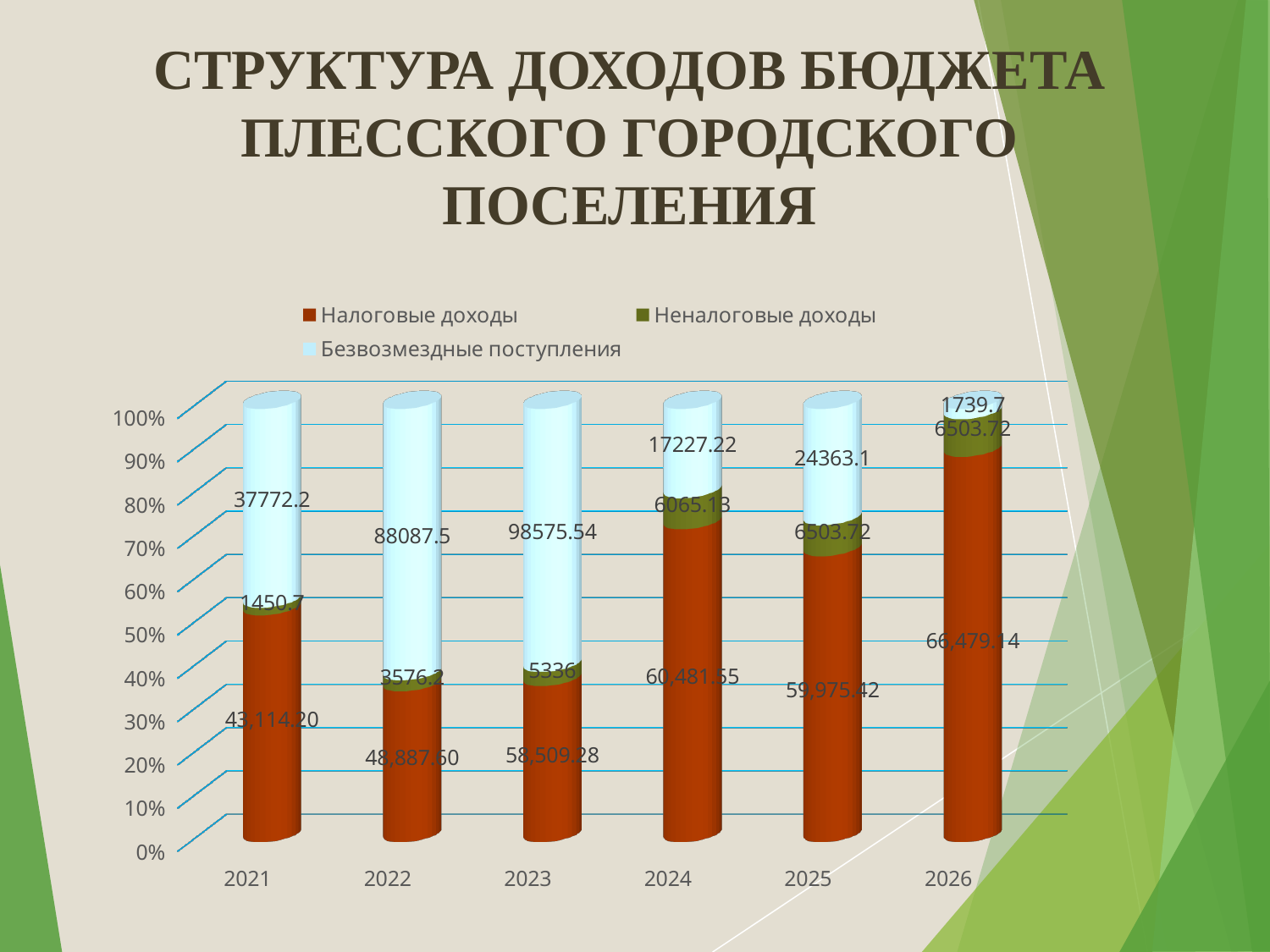
What is the value of Налоговые доходы for 2026? 66,479.14 In which year is the value of Налоговые доходы lowest? 2021 What is the value of Налоговые доходы for 2021? 43,114.20 Is the share of Налоговые доходы in the 2021 bar greater or less than 50%? greater How many years are shown on the x axis? 6 How many series does the legend list? 3 What type of chart is shown on the slide? stacked bar chart In which year is the value of Налоговые доходы highest? 2026 What is the difference between Безвозмездные поступления in 2023 and in 2022? 10488.04 What is the value of Неналоговые доходы for 2024? 6065.13 What is the value of Безвозмездные поступления for 2023? 98575.54 Which is larger, Безвозмездные поступления in 2024 or in 2025? 2025